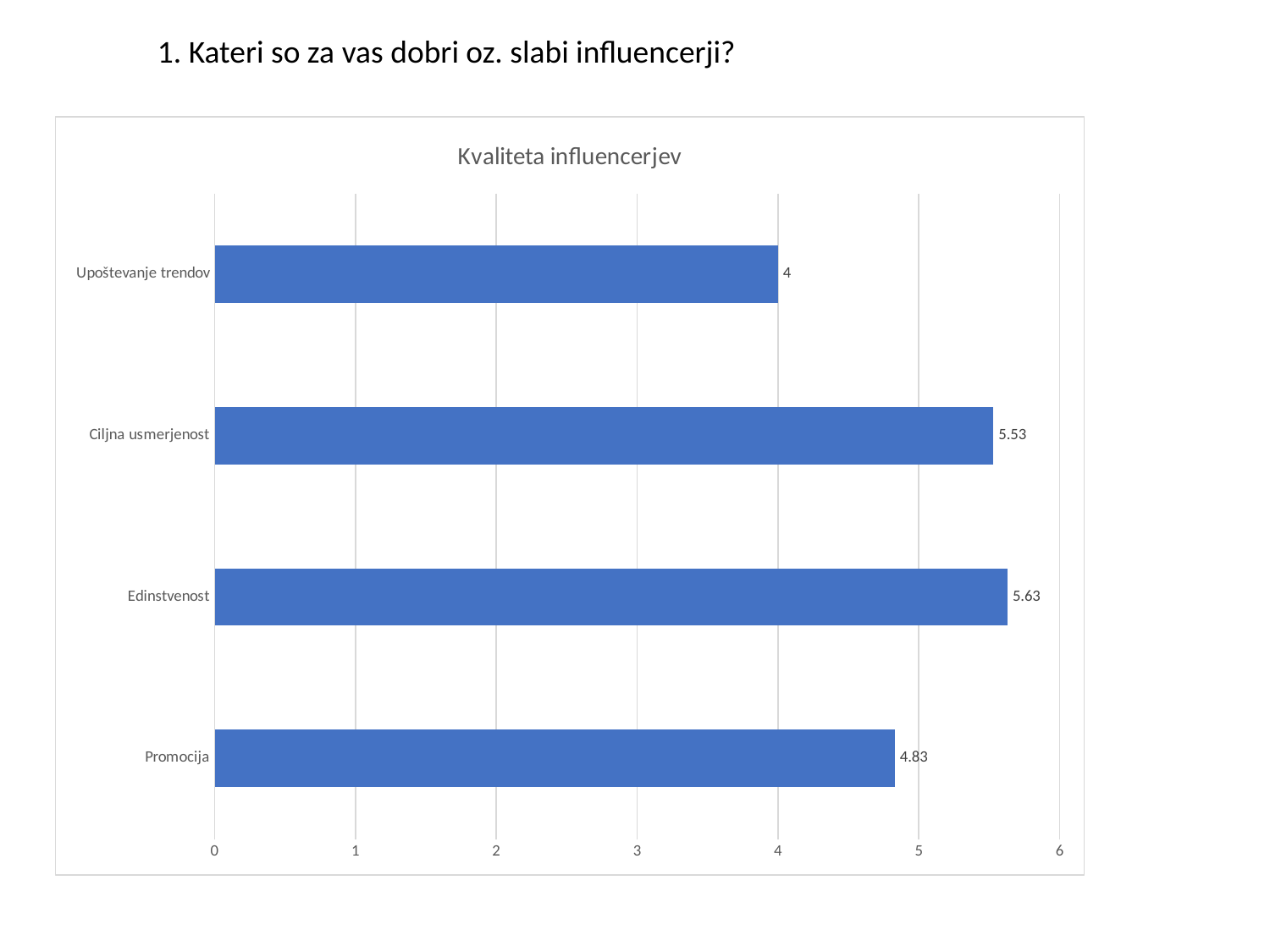
Which category has the lowest value? Upoštevanje trendov What is the value for Edinstvenost? 5.63 How many categories are shown in the chart? 4 Which is larger, the value for Promocija or the value for Upoštevanje trendov? Promocija Which category has the highest value? Edinstvenost What is the difference between the values for Edinstvenost and Promocija? 0.8 What is the value for Upoštevanje trendov? 4 What is the value for Promocija? 4.83 What is the title of the chart? Kvaliteta influencerjev What kind of chart is shown on the slide? Bar chart What is the value for Ciljna usmerjenost? 5.53 What is the difference between the values for Ciljna usmerjenost and Upoštevanje trendov? 1.53